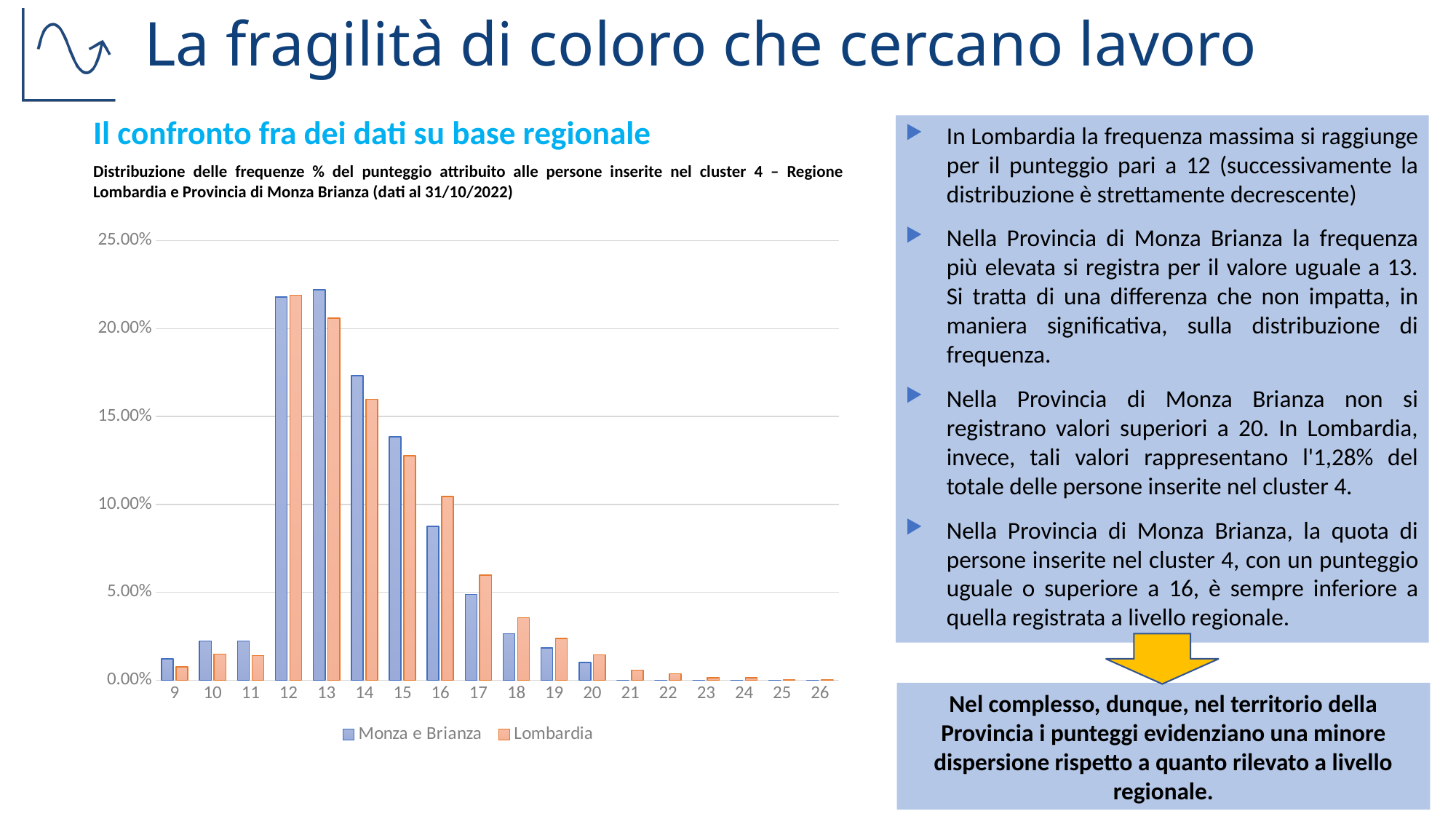
Is the Monza e Brianza value for score 14 greater or less than 15.00%? greater Is the Lombardia value for score 17 greater or less than 5.00%? greater Is the Lombardia value for score 15 greater or less than 15.00%? less How many series does the chart legend list? 2 For which score does the Lombardia series reach its highest value? 12 For score 16, which series has the larger value, Monza e Brianza or Lombardia? Lombardia Do the Lombardia values rise or fall as the score increases from 12 to 26? fall What kind of chart is shown on the slide? bar chart For score 13, which series has the larger value, Monza e Brianza or Lombardia? Monza e Brianza How many score categories are shown on the x axis of the chart? 18 Which colour represents the Lombardia series in the chart? orange